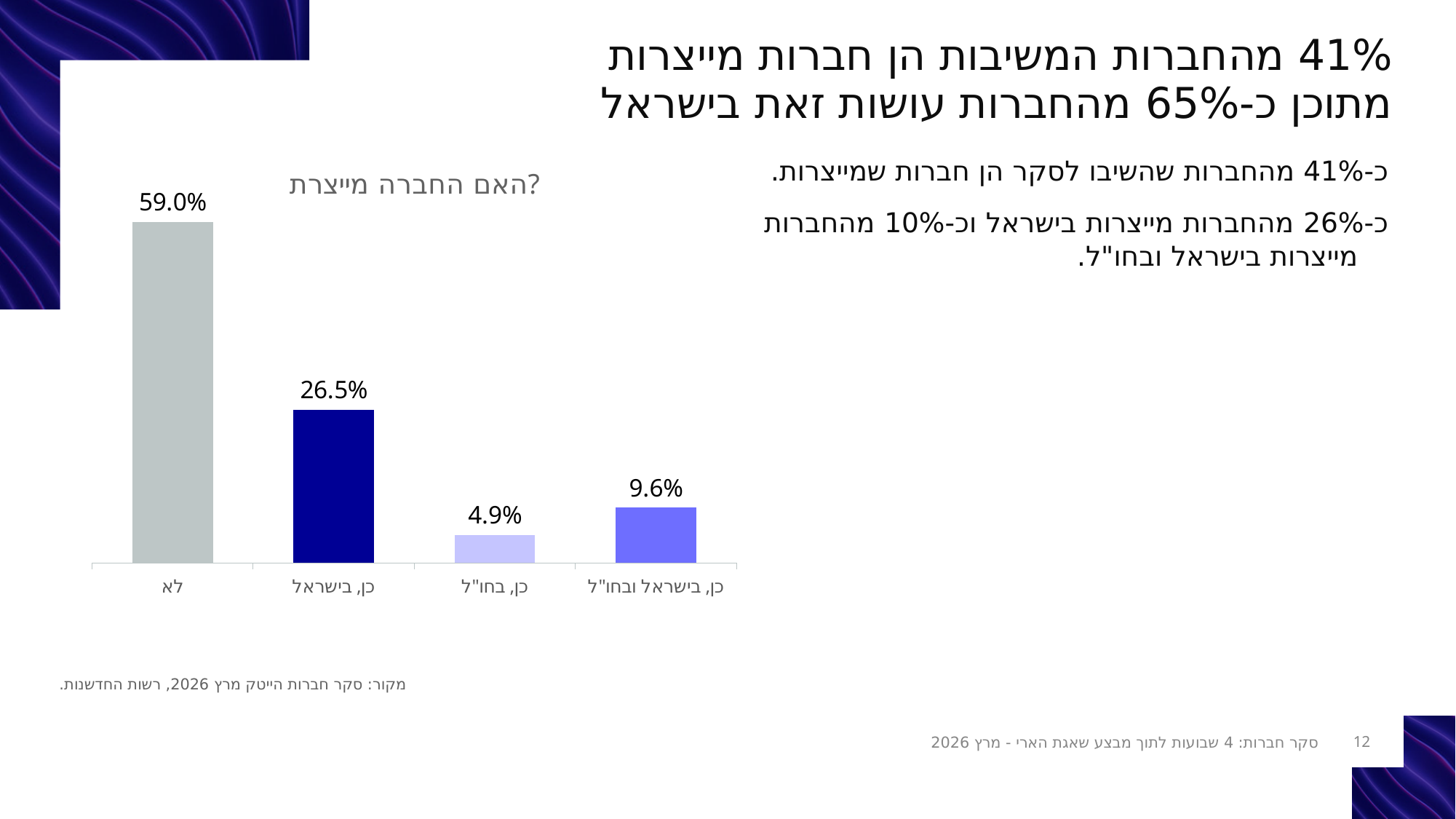
How many categories are shown in the chart? 4 What is the value for "כן, בישראל" in the chart? 26.5% Which category has the highest value in the chart? לא Which category has the lowest value in the chart? כן, בחו"ל What is the difference between the values for "כן, בישראל ובחו"ל" and "כן, בחו"ל"? 4.7% What is the value for the category "לא" in the chart "האם החברה מייצרת?"? 59.0% What kind of chart is shown on the slide? bar chart What is the difference between the values for "לא" and "כן, בישראל"? 32.5% What is the value for "כן, בחו"ל" in the chart? 4.9% What is the value for "כן, בישראל ובחו"ל" in the chart? 9.6% What is the title of the chart on the slide? האם החברה מייצרת? Which is larger: the value for "כן, בישראל ובחו"ל" or the value for "כן, בחו"ל"? כן, בישראל ובחו"ל